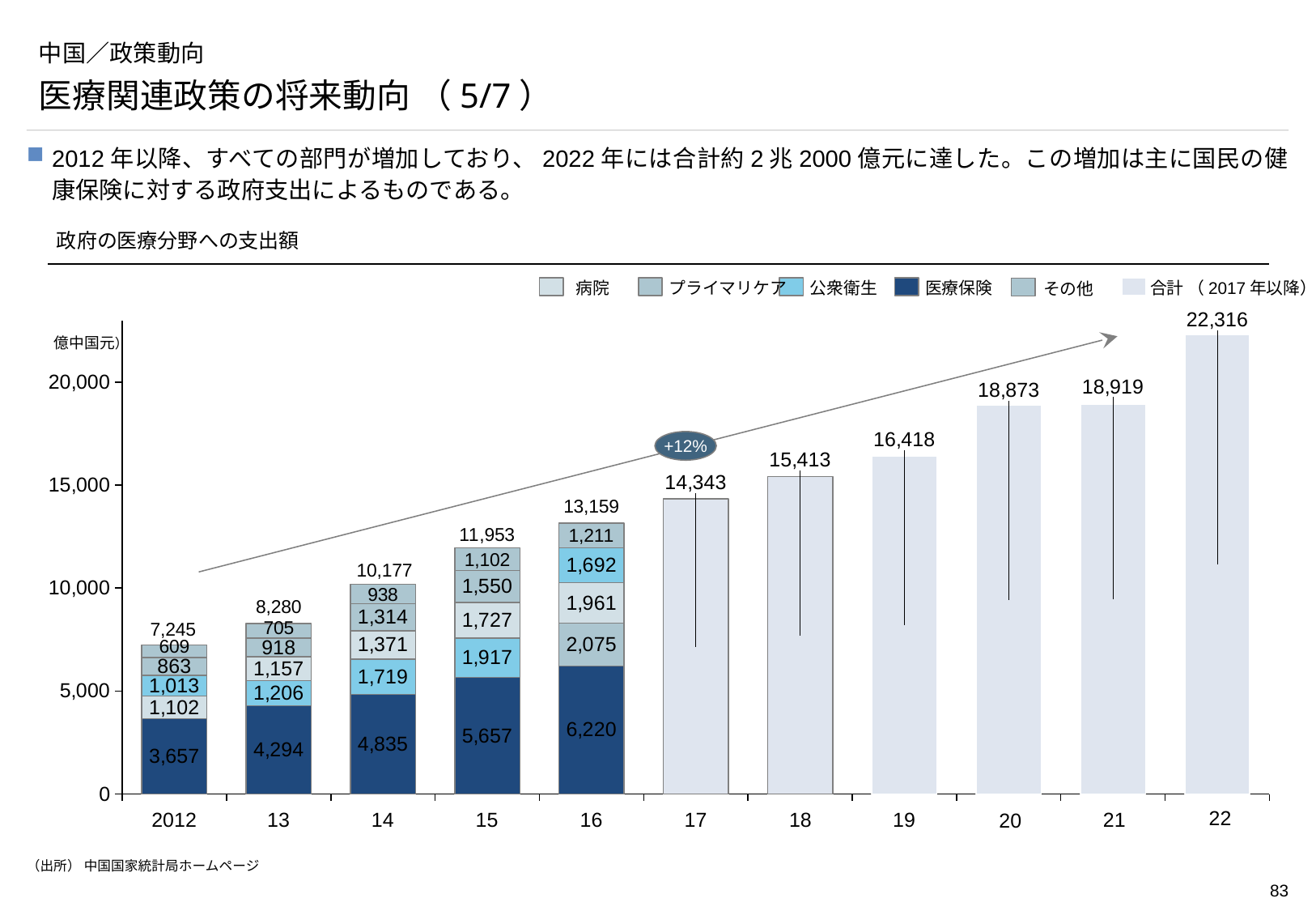
What is the total government health spending shown for 2022? 22,316 What is the total shown for 2012? 7,245 What is the difference between the totals for 2016 and 2015? 1,206 Which is larger, the total for 2018 or the total for 2019? 2019 How many years are plotted on the x axis? 11 What is the value of the 公衆衛生 segment in 2014? 1,719 Which year has the lowest total spending? 2012 Which year has the highest total spending? 22 What is the difference between the totals for 2022 and 2021? 3,397 What is the value of the 医療保険 segment in 2016? 6,220 How many entries does the legend list? 6 What type of chart is shown? Stacked bar chart